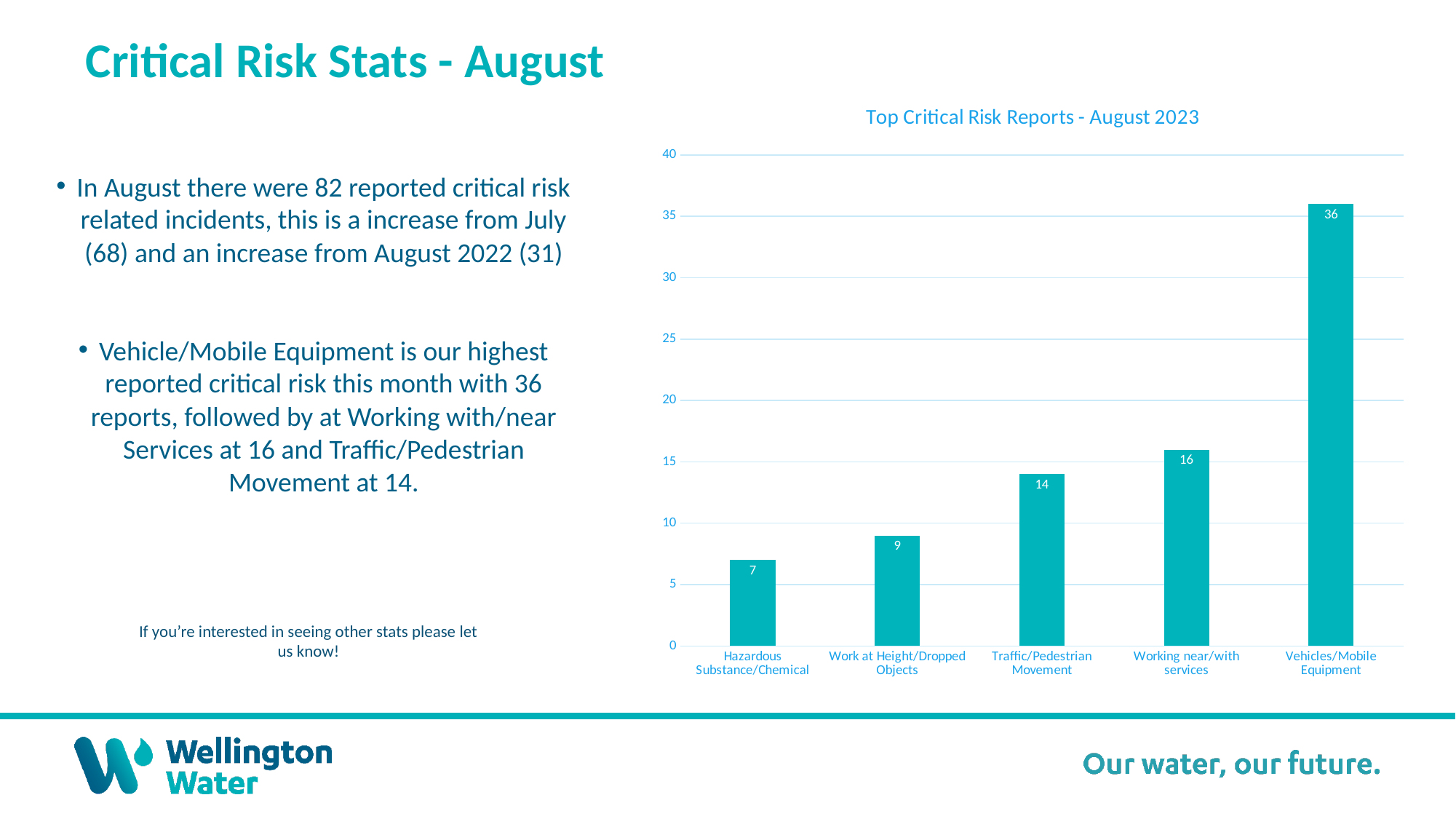
Which category has the highest value? Vehicles/Mobile Equipment Which is larger, Work at Height/Dropped Objects or Traffic/Pedestrian Movement? Traffic/Pedestrian Movement What is the title of the chart? Top Critical Risk Reports - August 2023 What is the difference between Vehicles/Mobile Equipment and Working near/with services? 20 What is the value for Working near/with services? 16 Is the value for Work at Height/Dropped Objects greater or less than 10? less What kind of chart is shown? bar chart What is the value for Traffic/Pedestrian Movement? 14 What is the value for Hazardous Substance/Chemical? 7 How many categories are shown on the chart? 5 Which category has the lowest value? Hazardous Substance/Chemical What is the value for Vehicles/Mobile Equipment? 36